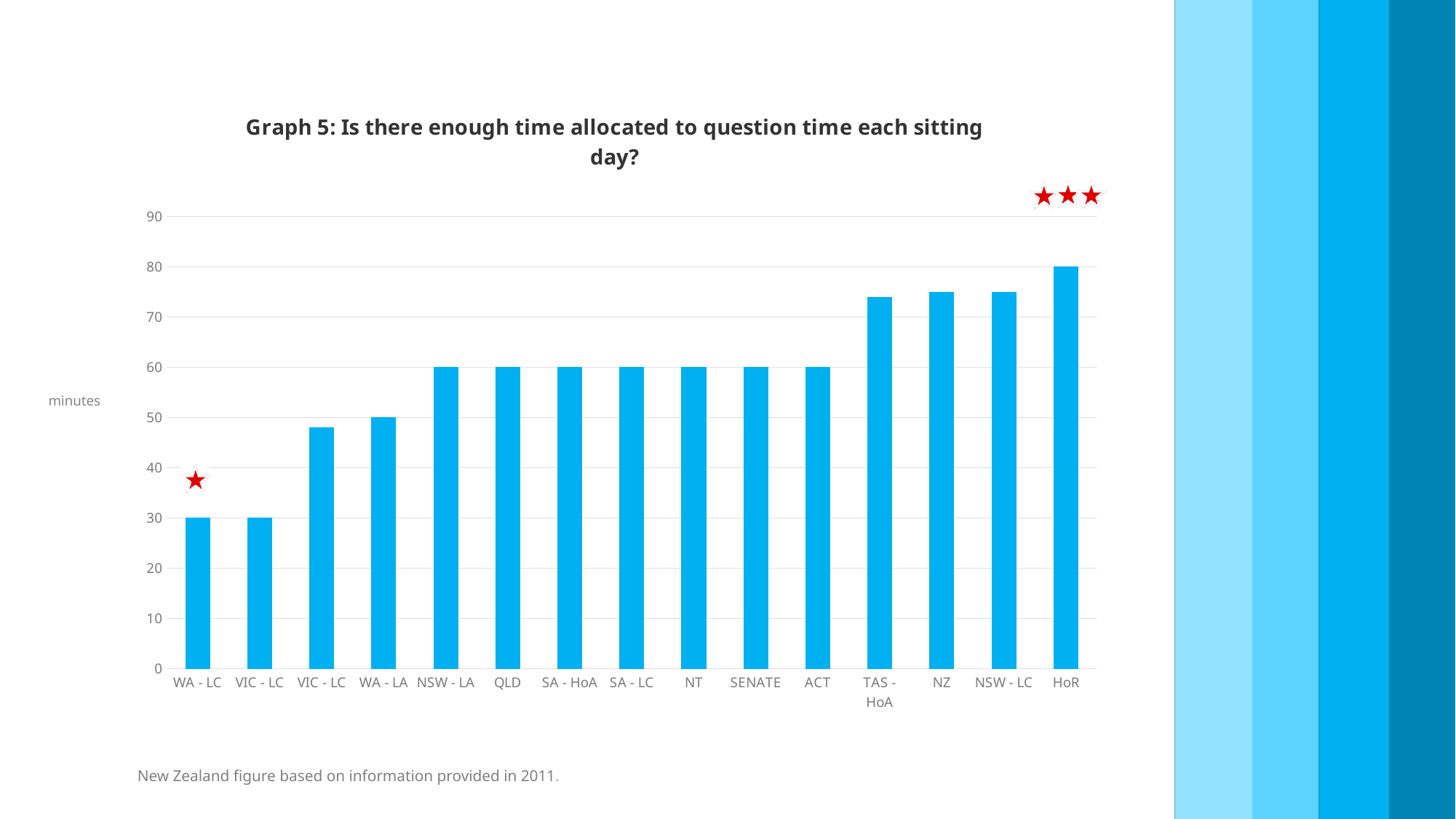
Which is larger, the value for HoR or the value for SENATE? HoR Which category has the highest value? HoR Is the value for NZ greater or less than 70? greater What is the value for WA - LC? 30 What is the difference between the values for HoR and WA - LA? 30 What is the value for WA - LA? 50 Do the values generally rise or fall from left to right along the x axis? rise What kind of chart is shown on the slide? bar chart What is the value for QLD? 60 Is the value for TAS - HoA greater or less than 70? greater How many categories are shown on the x axis? 15 What is the value for HoR? 80